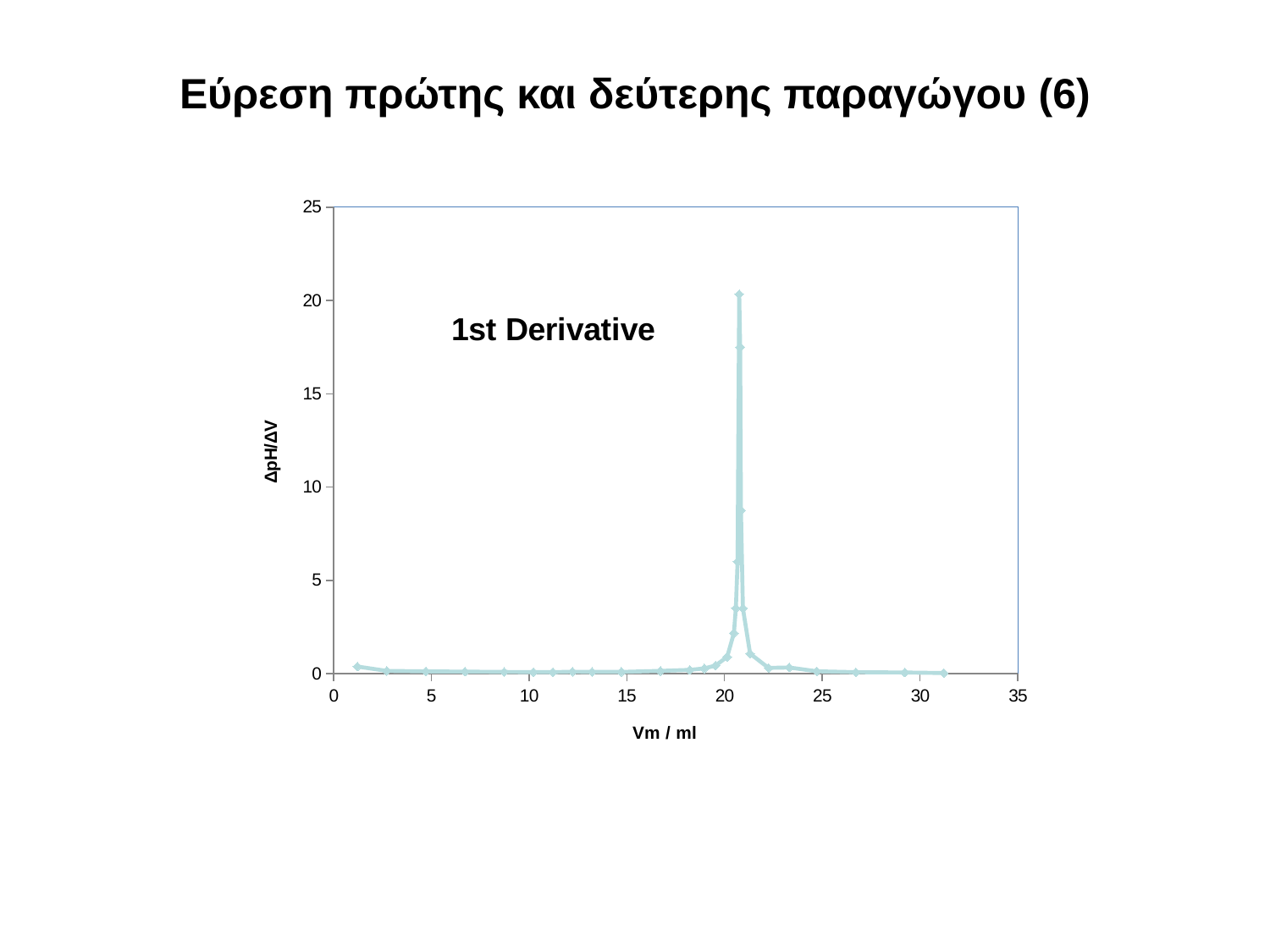
Is the peak value of the 1st Derivative curve greater or less than 15? greater What label is printed inside the plot area of the chart? 1st Derivative Is the value of the curve at Vm = 30 ml greater or less than 5? less What is the label of the x axis of the chart? Vm / ml Between which two labelled x-axis ticks does the peak of the curve occur? 20 and 25 What is the highest value shown on the y axis of the chart? 25 Is the value of the curve at Vm = 5 ml greater or less than 5? less What kind of chart is shown on the slide? line chart Do the values of the curve rise or fall as Vm increases from 15 ml to 20 ml? rise Do the values of the curve rise or fall as Vm increases from 25 ml to 30 ml? fall